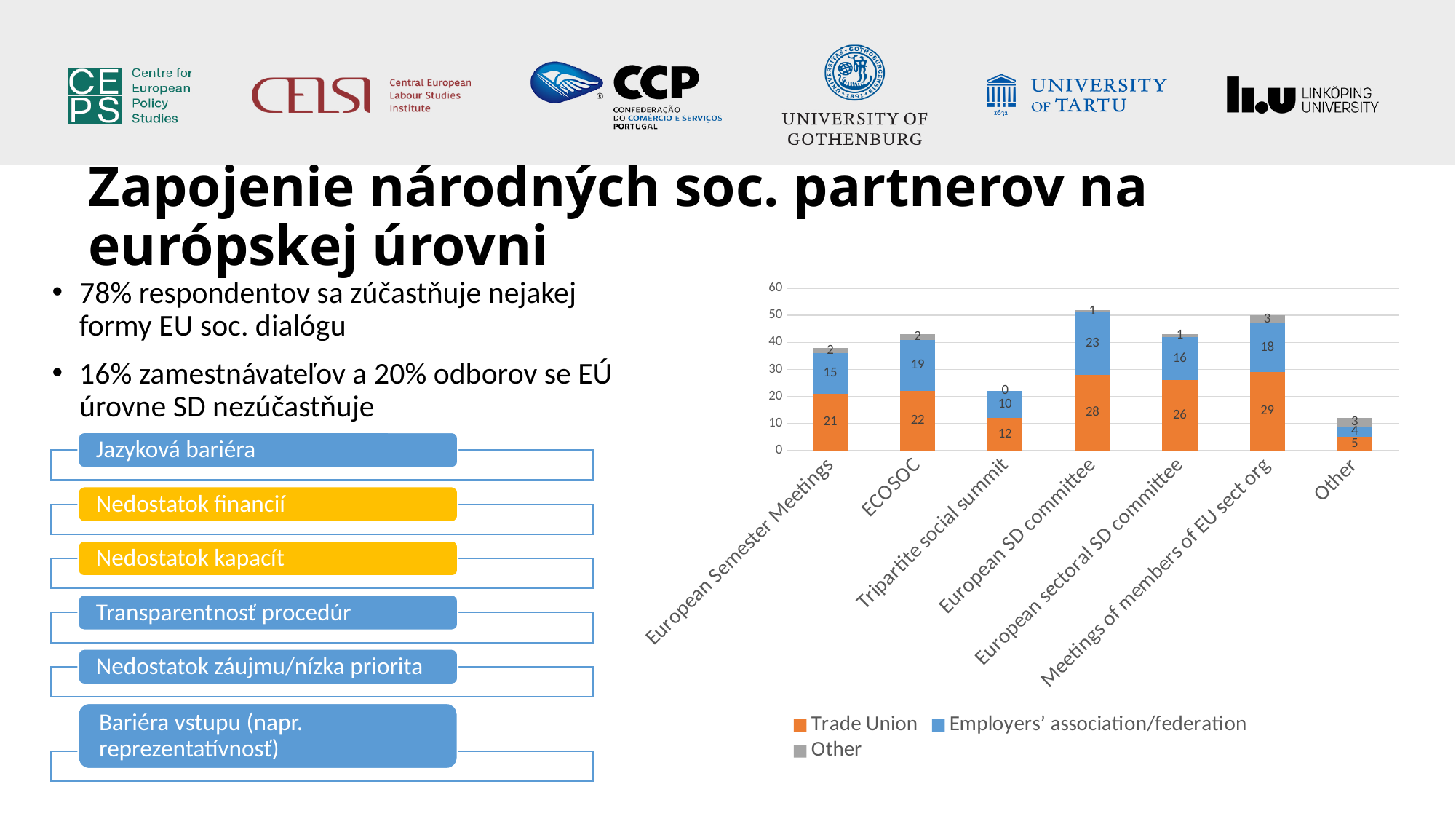
What is the total of the stacked bar for ECOSOC? 43 Which category has the lowest Employers' association/federation value? Other Which is larger: the Employers' association/federation value for European Semester Meetings or for European sectoral SD committee? European sectoral SD committee Which category has the highest Trade Union value? Meetings of members of EU sect org What is the Trade Union value for European SD committee? 28 What is the total of the stacked bar for Tripartite social summit? 22 What is the Employers' association/federation value for ECOSOC? 19 How many series does the chart legend list? 3 What type of chart is shown on the slide? Stacked bar chart How many categories are shown on the x axis of the chart? 7 What is the difference between the Trade Union values for European SD committee and Tripartite social summit? 16 What is the Other series value for Meetings of members of EU sect org? 3